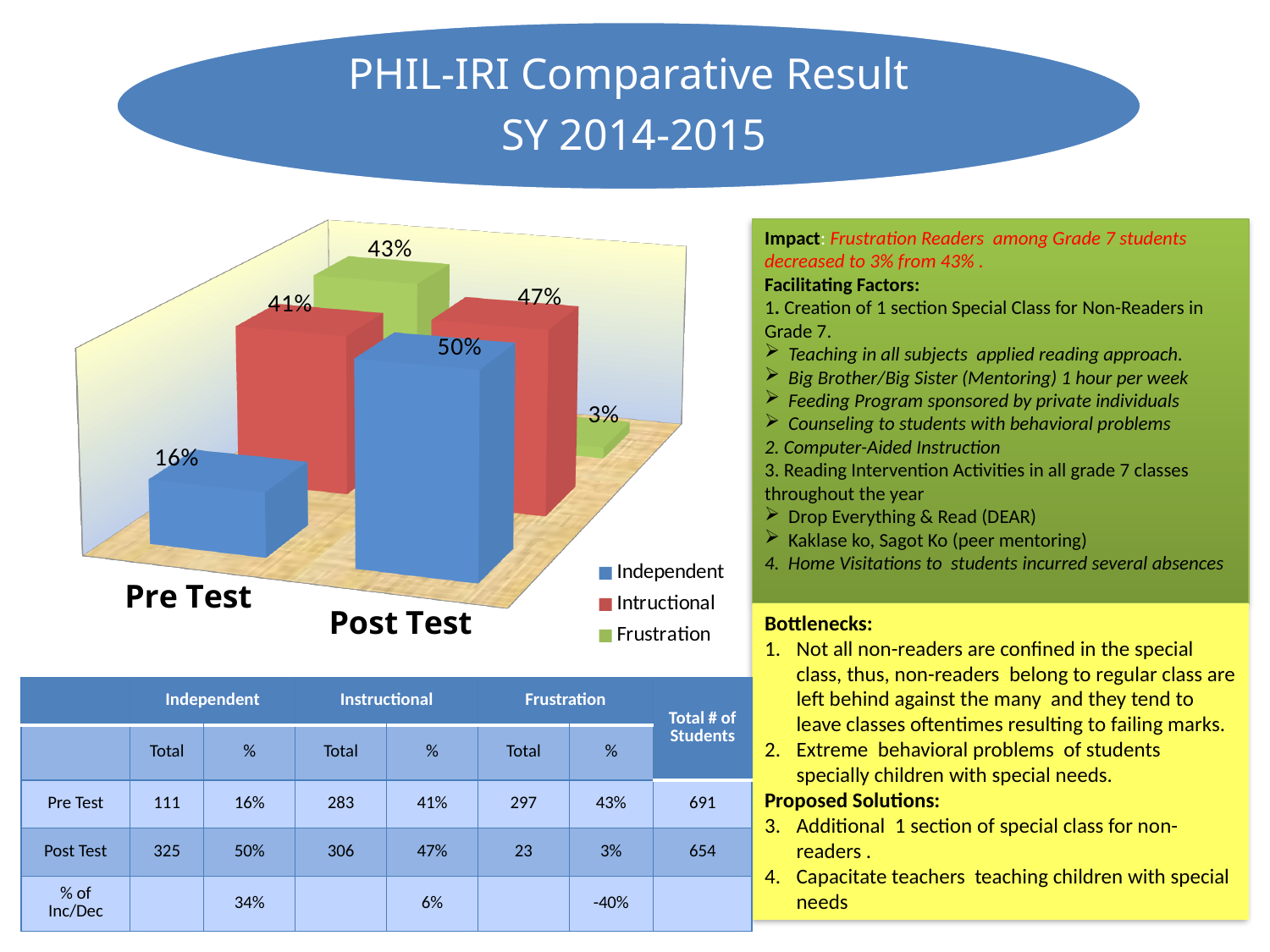
Which is larger, the Independent value for Post Test or the Intructional value for Post Test? Independent value for Post Test What is the Frustration value for Post Test? 3% What is the difference between the Frustration values for Pre Test and Post Test? 40% What is the Independent value for Pre Test? 16% What is the difference between the Independent values for Post Test and Pre Test? 34% How many series does the chart legend list? 3 Which series has the lowest value for Post Test? Frustration How many categories are shown on the chart? 2 What kind of chart is shown on the slide? Bar chart What is the Intructional value for Post Test? 47% What is the Frustration value for Pre Test? 43% Which series has the highest value for Pre Test? Frustration